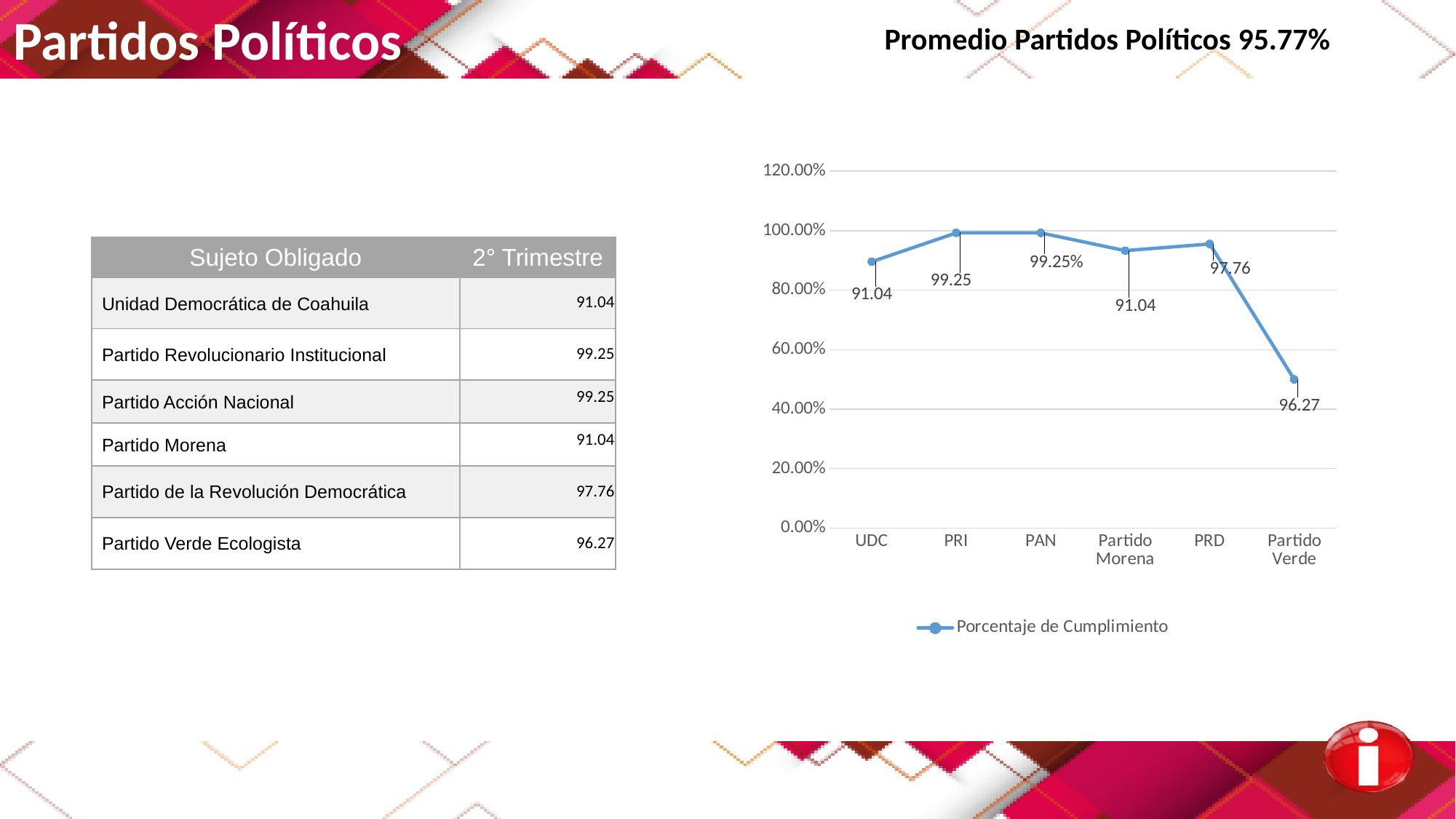
What is the data label for PRI in the chart? 99.25 What is the data label for Partido Morena in the chart? 91.04 What is the difference between the labelled values for PRI and UDC? 8.21 How many categories are shown on the x axis of the chart? 6 Which has a higher value in the chart, PRD or UDC? PRD What is the data label for PRD in the chart? 97.76 How many series does the chart legend list? 1 Is the value for UDC greater or less than 80.00%? greater What is the data label for PAN in the chart? 99.25% What is the name of the series shown in the chart legend? Porcentaje de Cumplimiento What is the data label for UDC in the chart? 91.04 What kind of chart is shown on the slide? line chart